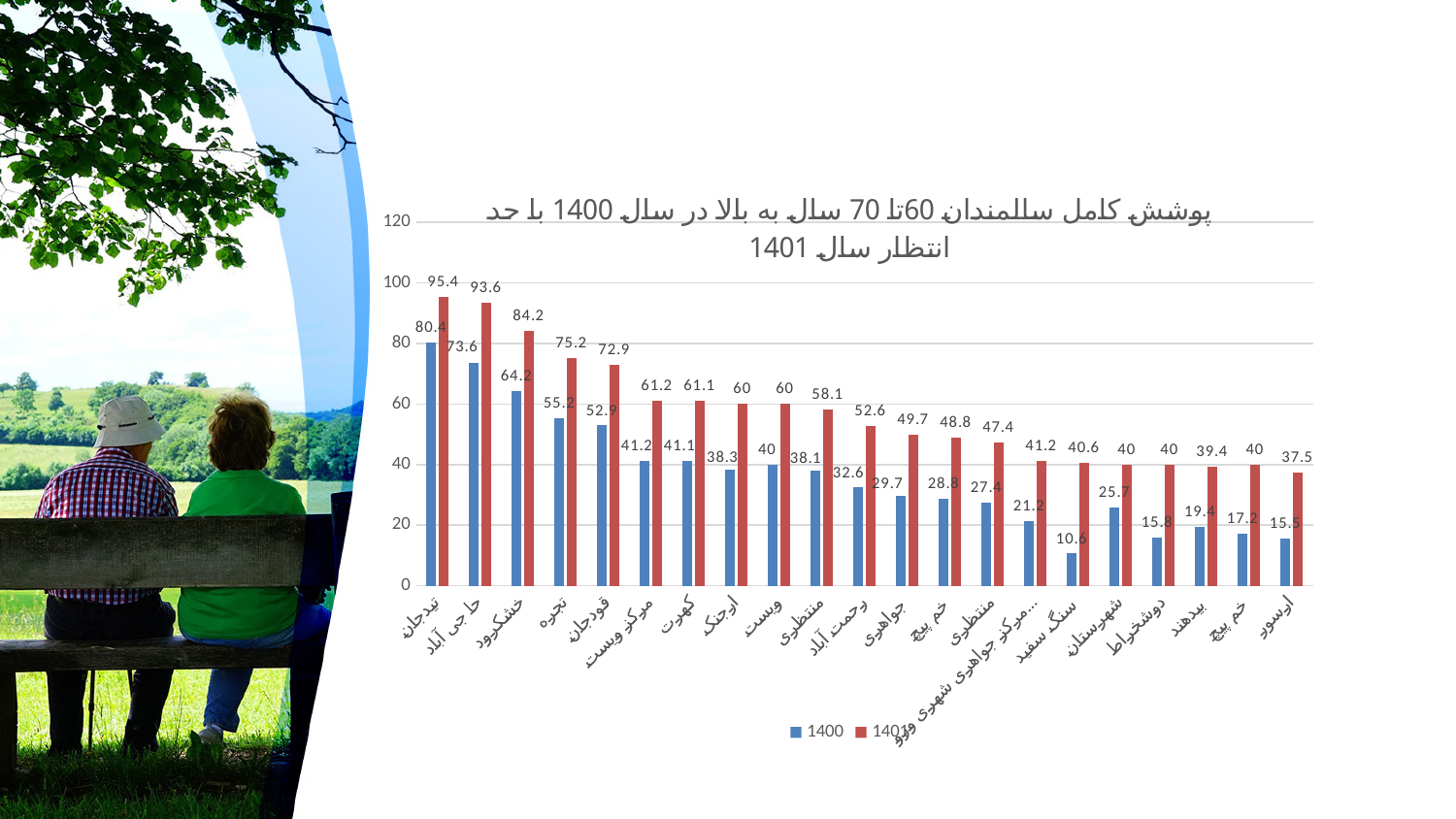
How many series does the legend list? 2 Which category has the lowest value in the 1400 series? سنگ سفید Is the 1401 value for اریسود greater or less than 40? less Which colour represents the 1401 series in the legend? red What is the difference between the 1401 and 1400 values for خشکرود? 20 Which is larger: the 1400 value for قودجان or the 1400 value for نجره? نجره How many categories are shown on the x axis? 21 Which category has the highest value in the 1401 series? بیدجان What is the value for بیدجان in the 1401 series? 95.4 What is the value for سنگ سفید in the 1400 series? 10.6 What kind of chart is shown on the slide? bar chart What is the value for حاجی آباد in the 1400 series? 73.6